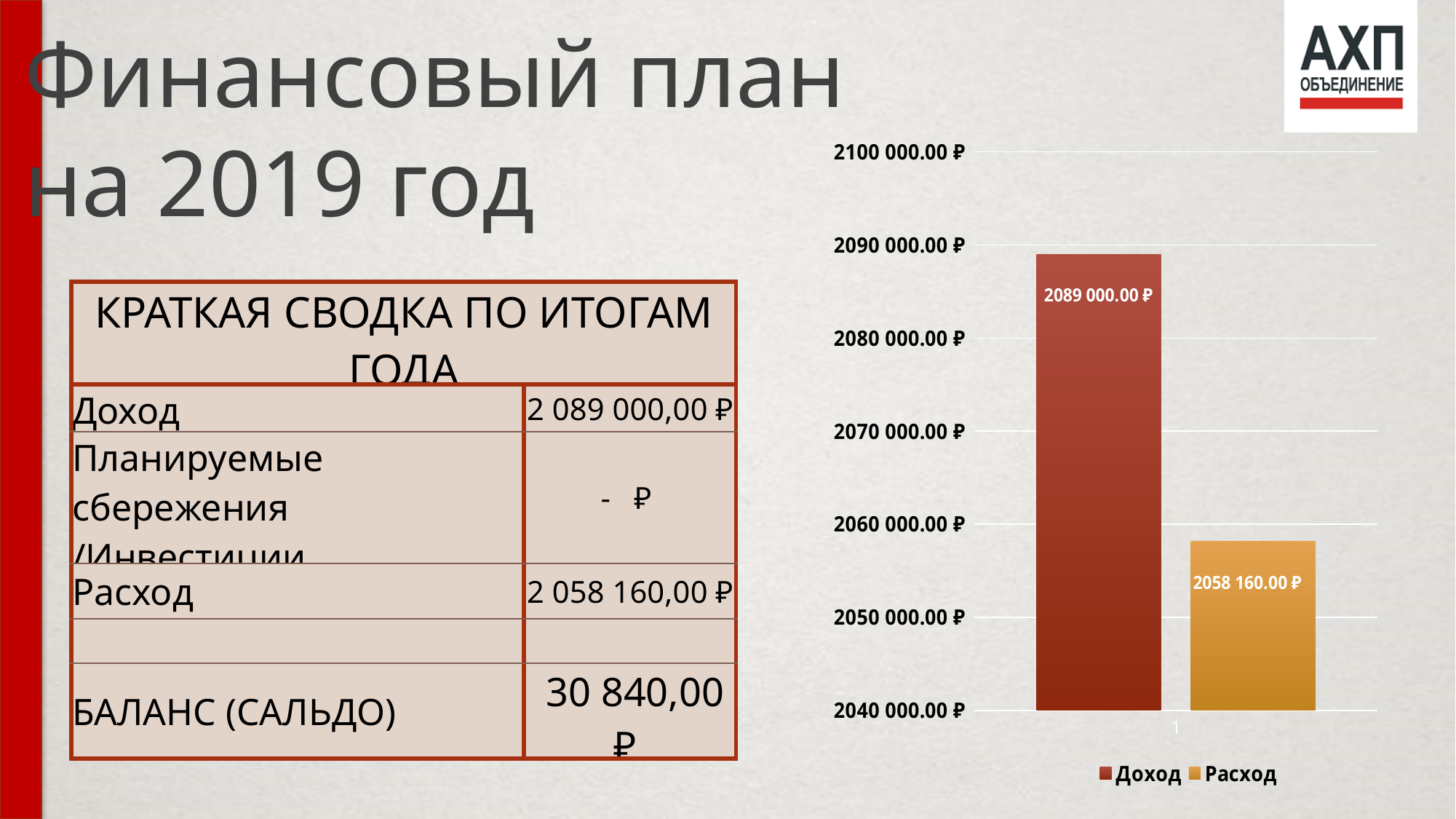
Which series has the highest value in the chart? Доход What is the highest value shown on the chart's vertical axis? 2100 000.00 ₽ What is the value of the Расход bar in the chart? 2058 160.00 ₽ Which series has the higher value in the chart, Доход or Расход? Доход Is the value for Расход greater or less than 2060 000.00 ₽? less What colour is the Доход bar in the chart? dark red Which series has the lowest value in the chart? Расход What is the difference between the Доход and Расход values in the chart? 30 840.00 ₽ Is the value for Доход greater or less than 2080 000.00 ₽? greater How many series does the chart legend list? 2 What is the value of the Доход bar in the chart? 2089 000.00 ₽ What kind of chart is shown on the slide? bar chart